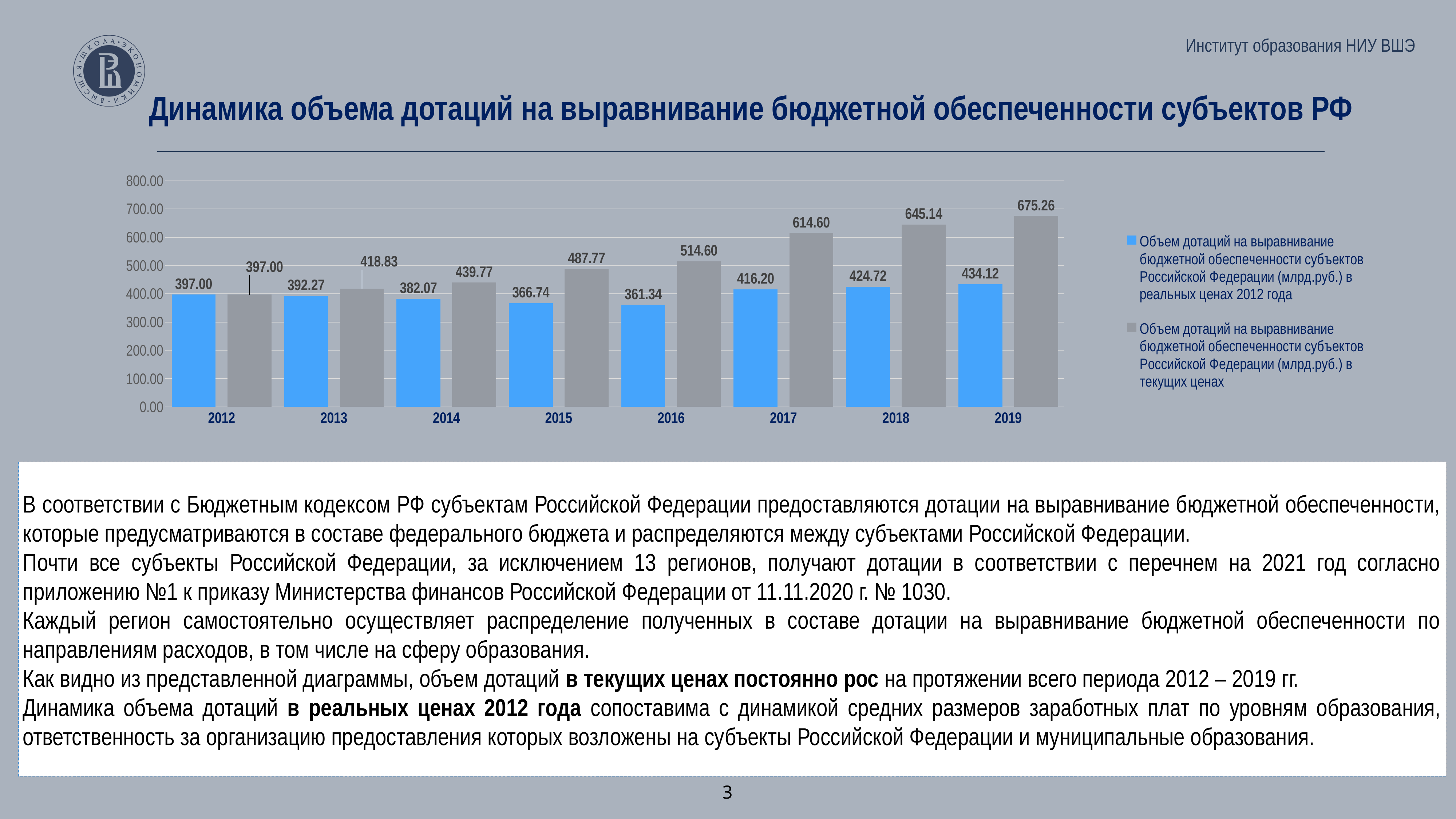
What is the value of the current-prices series for 2015? 487.77 Is the current-prices value for 2018 greater or less than 600? greater In which year is the real-prices-2012 series at its lowest? 2016 What is the difference between the current-prices value and the real-prices-2012 value for 2019? 241.14 Which is larger in 2017: the current-prices value or the real-prices-2012 value? the current-prices value (614.60) What kind of chart is shown on the slide? bar chart How many years are shown on the x axis? 8 How many series does the legend list? 2 Does the current-prices series rise or fall from 2012 to 2019? rise In which year is the current-prices series at its highest? 2019 What is the value of the current-prices series (текущих ценах) for 2019? 675.26 What is the value of the real-prices-2012 series (реальных ценах 2012 года) for 2016? 361.34